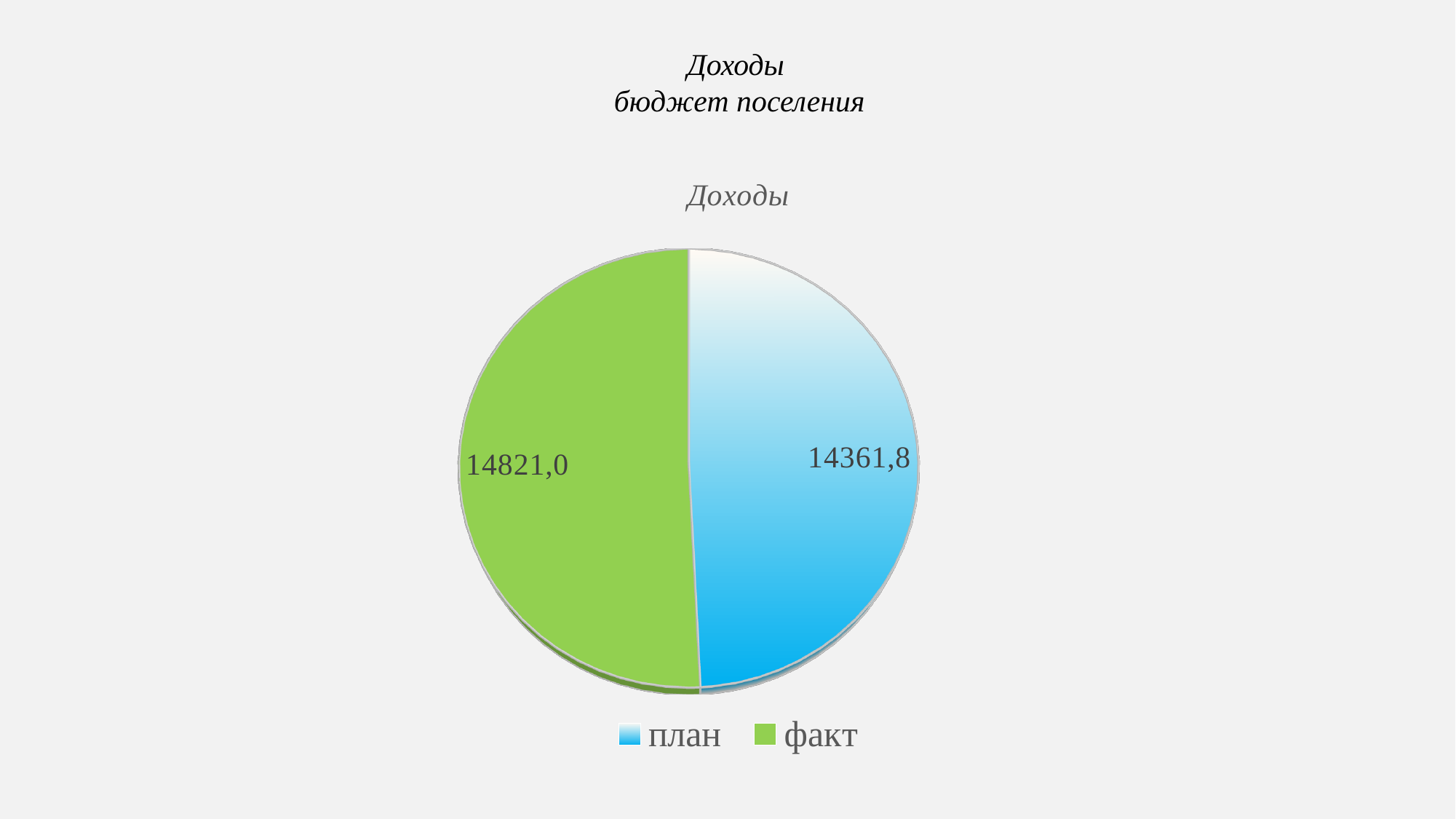
What is the difference between the факт and план values in the Доходы pie chart? 459,2 How many slices does the Доходы pie chart have? 2 How many entries does the legend of the Доходы chart list? 2 Is the факт value larger or smaller than the план value in the Доходы pie chart? larger What is the value of the факт slice in the Доходы pie chart? 14821,0 Which slice of the Доходы pie chart has the larger value? факт Which slice of the Доходы pie chart has the smaller value? план What is the title of the pie chart on the slide? Доходы What is the total of the two slices in the Доходы pie chart? 29182,8 What kind of chart is shown on the slide? pie chart What is the value of the план slice in the Доходы pie chart? 14361,8 What colour is the факт slice in the Доходы pie chart? green